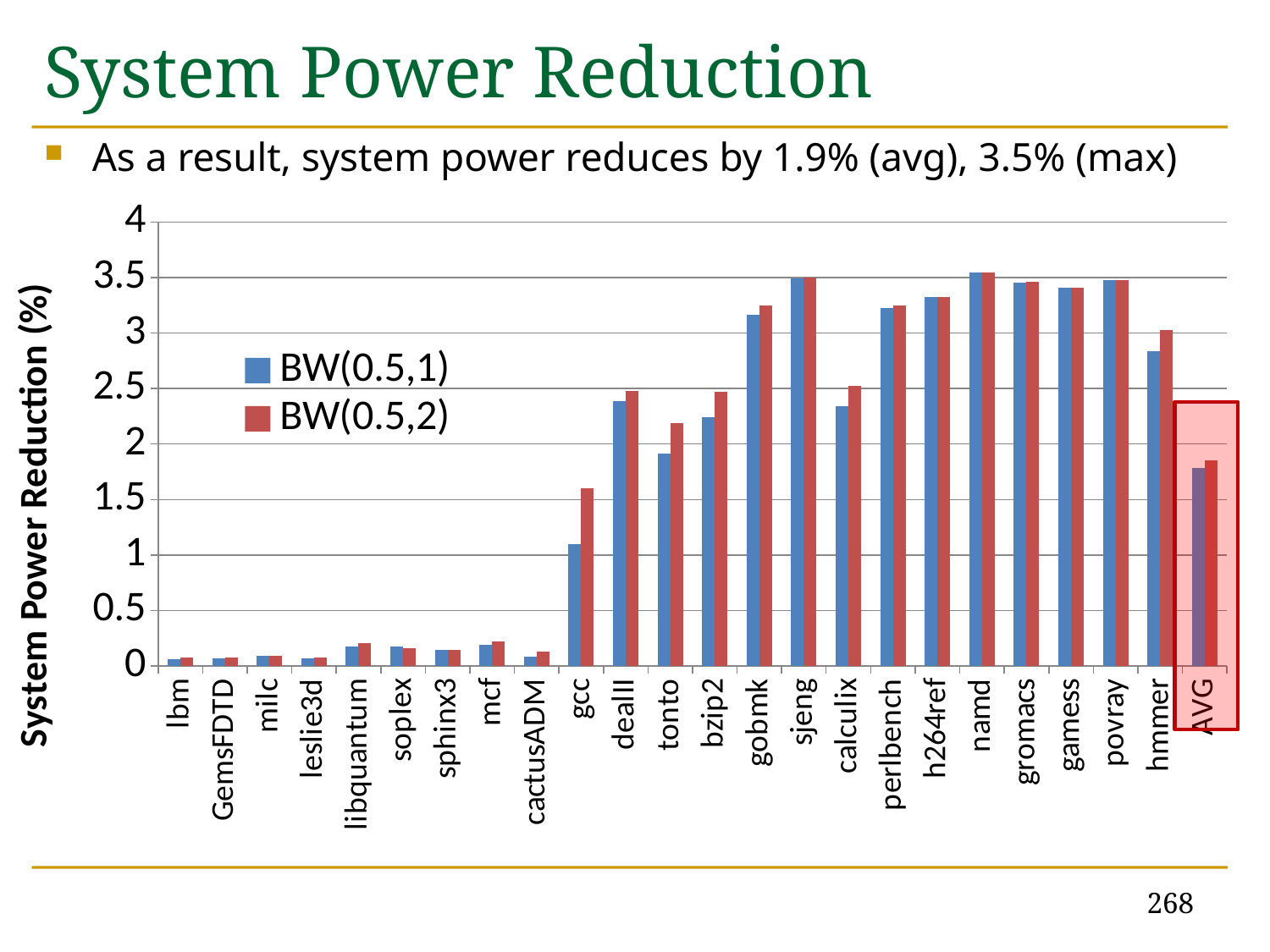
Which has the larger BW(0.5,1) value, gcc or dealII? dealII For gcc, which series has the larger value, BW(0.5,1) or BW(0.5,2)? BW(0.5,2) How many series does the legend list? 2 Is the BW(0.5,1) value for hmmer greater or less than 3? less Is the BW(0.5,1) value for gcc greater or less than 1? greater What is the title of the y axis? System Power Reduction (%) How many categories are shown on the x axis? 24 Is the BW(0.5,1) value for lbm greater or less than 0.5? less Which category on the x axis is highlighted with a red box? AVG What kind of chart is shown on the slide? bar chart